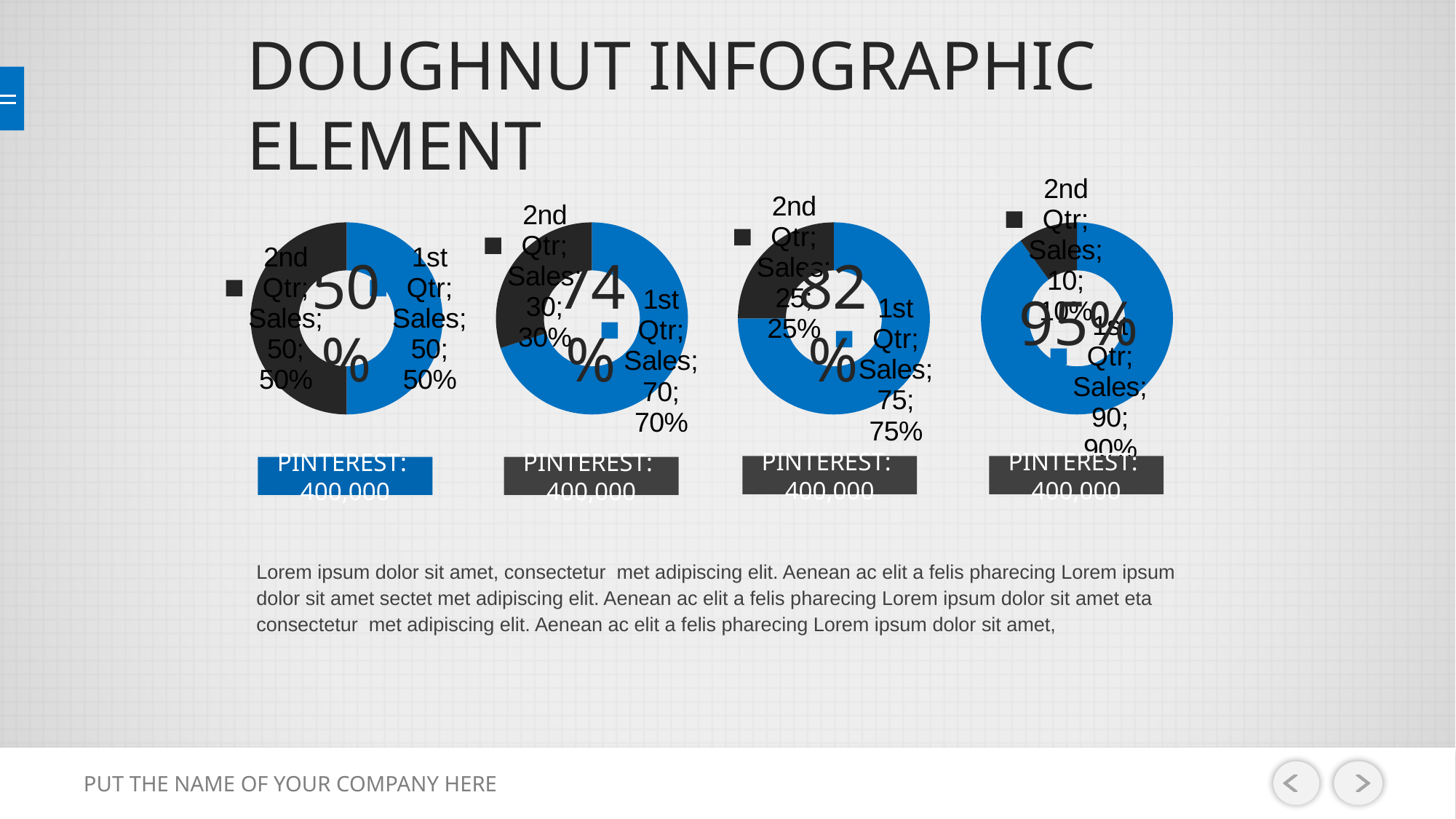
In the third doughnut chart from the left, which slice is larger, 1st Qtr Sales or 2nd Qtr Sales? 1st Qtr Sales In the second doughnut chart from the left, what is the value labelled for 2nd Qtr Sales? 30 In the second doughnut chart from the left, what is the difference between the 1st Qtr Sales and 2nd Qtr Sales values? 40 In the rightmost doughnut chart, what percentage is shown for 2nd Qtr Sales? 10% In the second doughnut chart from the left, what percentage is shown for 1st Qtr Sales? 70% What type of chart is used for each of the four charts on the slide? Doughnut chart In the third doughnut chart from the left, what percentage is shown for 2nd Qtr Sales? 25% How many slices does each doughnut chart on the slide have? 2 In the leftmost doughnut chart, what is the value labelled for 1st Qtr Sales? 50 In the rightmost doughnut chart, which slice is the smallest? 2nd Qtr Sales In the rightmost doughnut chart, what is the value labelled for 1st Qtr Sales? 90 What colour is the 1st Qtr Sales slice in the doughnut charts? Blue